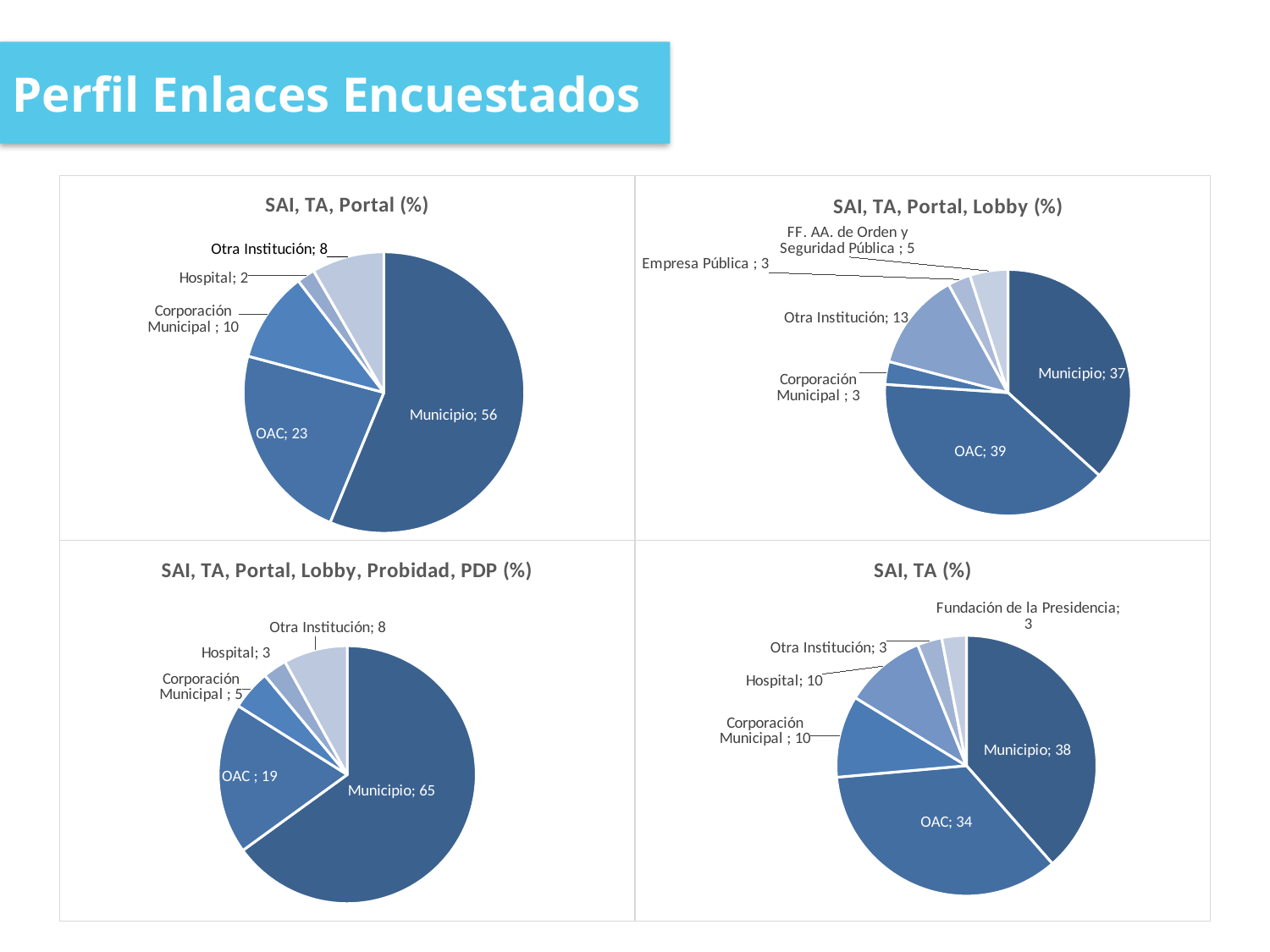
In the 'SAI, TA, Portal (%)' chart, what is the value for Municipio? 56 In the 'SAI, TA, Portal, Lobby, Probidad, PDP (%)' chart, what is the value for OAC? 19 In the 'SAI, TA (%)' chart, what is the value for Fundación de la Presidencia? 3 How many charts are shown on the slide? 4 How many categories are shown in the 'SAI, TA, Portal (%)' chart? 5 In the 'SAI, TA, Portal, Lobby (%)' chart, which category has the largest slice? OAC In the 'SAI, TA, Portal (%)' chart, which category has the smallest slice? Hospital In the 'SAI, TA, Portal, Lobby, Probidad, PDP (%)' chart, what is the difference between Municipio and OAC? 46 What kind of chart is the 'SAI, TA (%)' chart? Pie chart In the 'SAI, TA, Portal, Lobby (%)' chart, what is the value for Otra Institución? 13 How many categories are shown in the 'SAI, TA, Portal, Lobby (%)' chart? 6 In the 'SAI, TA (%)' chart, which is larger, Municipio or OAC? Municipio